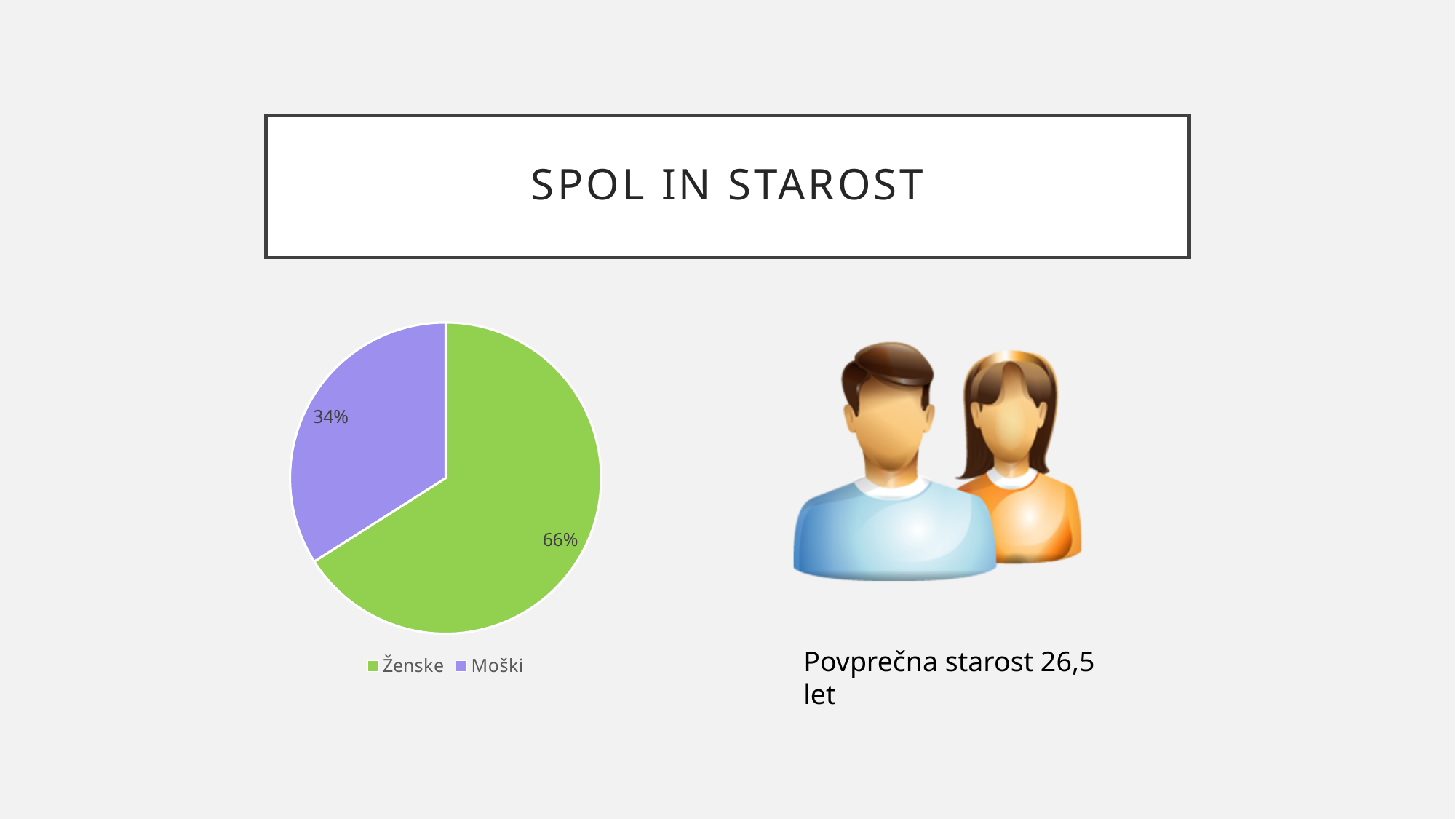
What is the difference in percentage points between the Ženske and Moški slices? 32 What colour is the Moški slice in the pie chart? purple How many categories does the pie chart show? 2 What share of the pie chart is Moški? 34% Which category has the smallest slice in the pie chart? Moški Which category has the largest slice in the pie chart? Ženske Which slice is larger, Ženske or Moški? Ženske Is the share for Ženske greater or less than 50%? greater What share of the pie chart is Ženske? 66% What colour is the Ženske slice in the pie chart? green What kind of chart is shown on the slide? pie chart